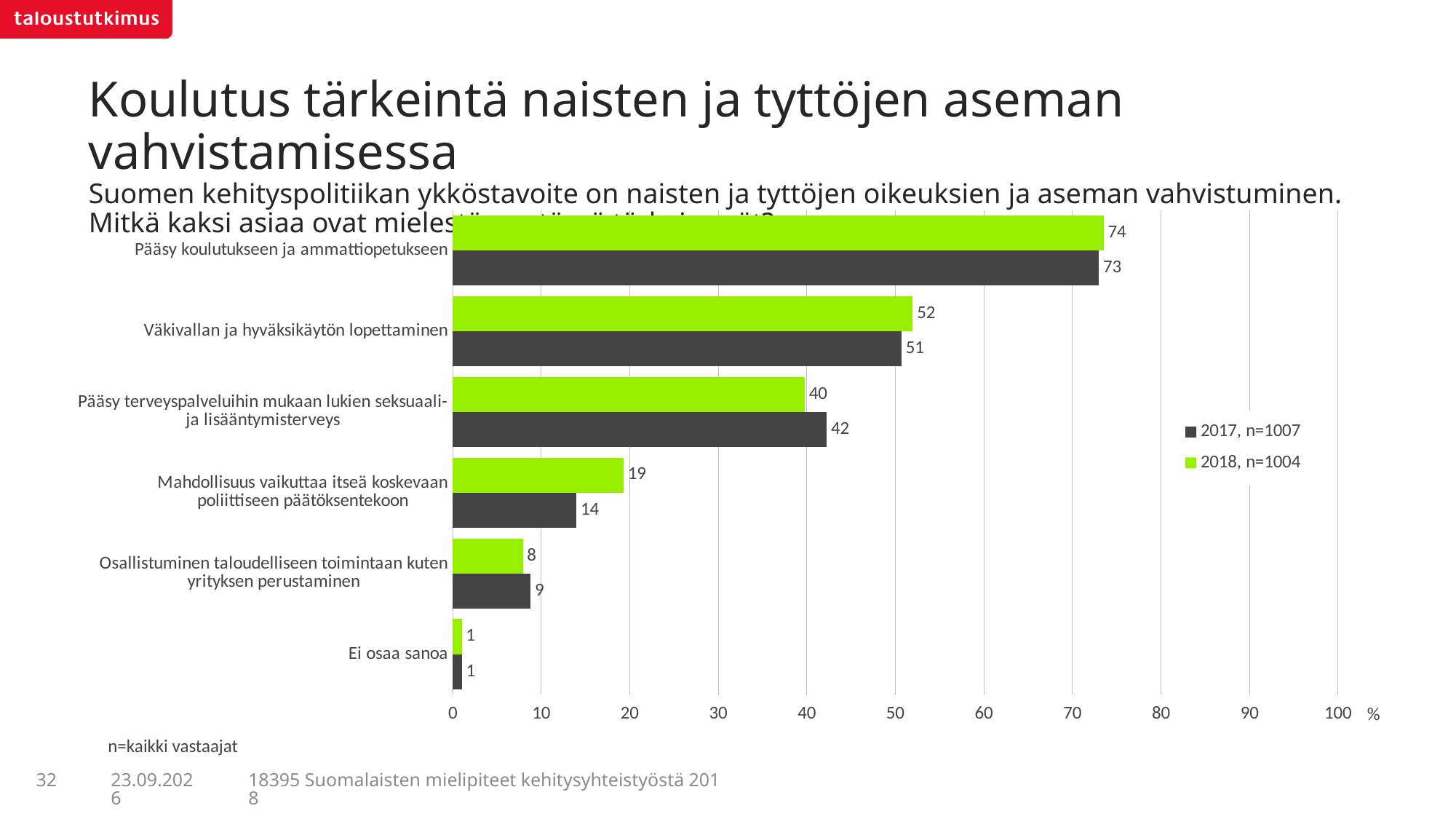
What is the difference between the 2017 and 2018 values for "Mahdollisuus vaikuttaa itseä koskevaan poliittiseen päätöksentekoon"? 5 Which category has the lowest 2017 value? Ei osaa sanoa Which category has the highest 2018 value? Pääsy koulutukseen ja ammattiopetukseen What is the 2017 value for "Mahdollisuus vaikuttaa itseä koskevaan poliittiseen päätöksentekoon"? 14 What is the 2018 value for "Pääsy koulutukseen ja ammattiopetukseen"? 74 How many series does the legend list? 2 What kind of chart is shown on the slide? bar chart How many categories are shown on the chart? 6 For "Pääsy terveyspalveluihin mukaan lukien seksuaali- ja lisääntymisterveys", which year has the larger value, 2017 or 2018? 2017 Which colour represents the 2018 series in the legend? green What is the 2017 value for "Väkivallan ja hyväksikäytön lopettaminen"? 51 Is the 2018 value for "Väkivallan ja hyväksikäytön lopettaminen" greater or less than 50? greater